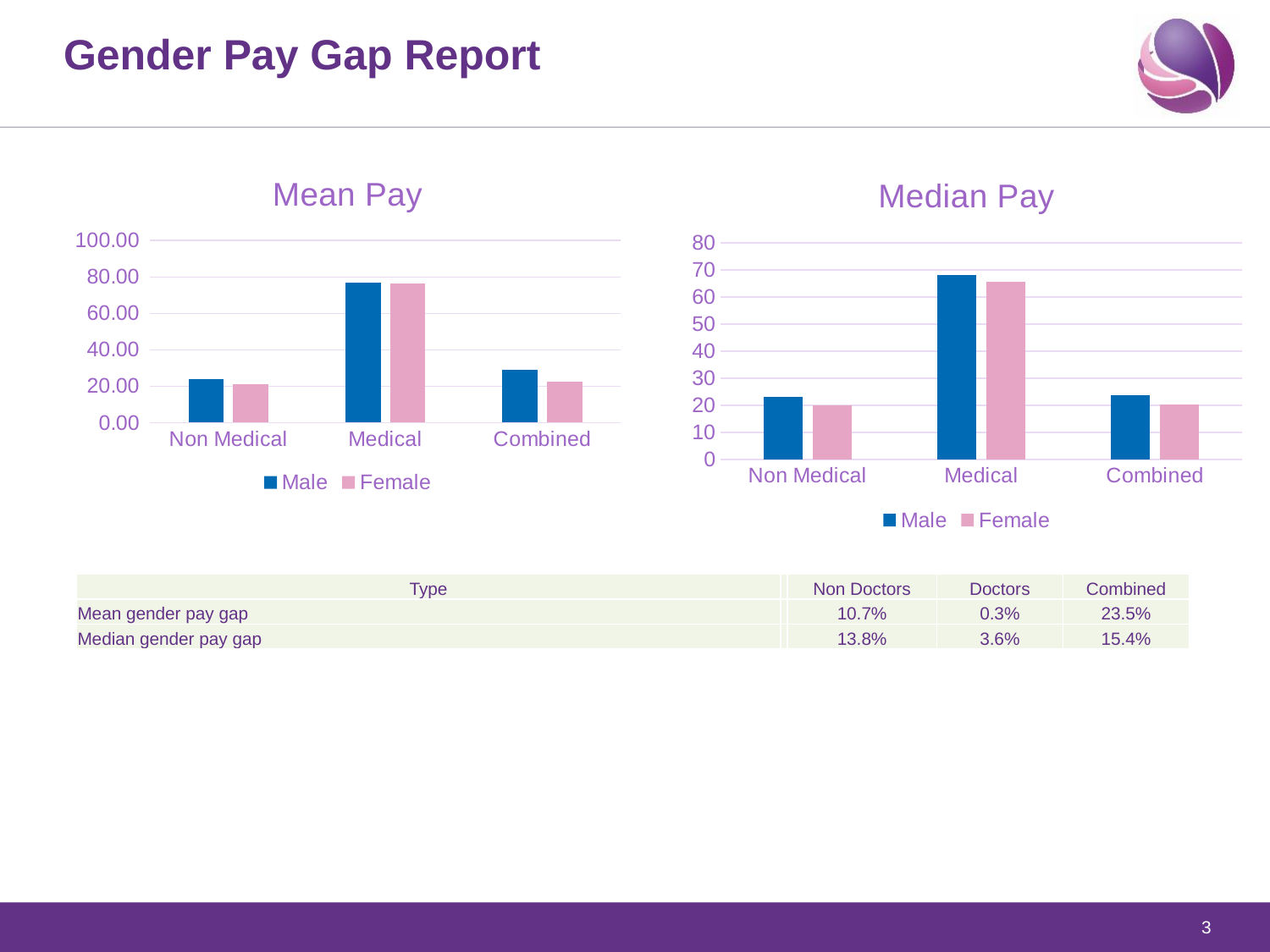
In the Median Pay chart, which is larger for Non Medical, the Male value or the Female value? Male In the Median Pay chart, is the Female value for Medical greater or less than 50? greater In the Mean Pay chart, which category has the highest Male value? Medical How many categories are shown on the x axis of the Mean Pay chart? 3 What are the two legend entries in the Mean Pay chart? Male and Female In the Mean Pay chart, which is larger for Combined, the Male value or the Female value? Male In the Mean Pay chart, is the Female value for Combined greater or less than 40.00? less How many series does the legend of the Median Pay chart list? 2 In the Mean Pay chart, is the Male value for Medical greater or less than 60.00? greater What kind of chart is the Mean Pay chart? bar chart